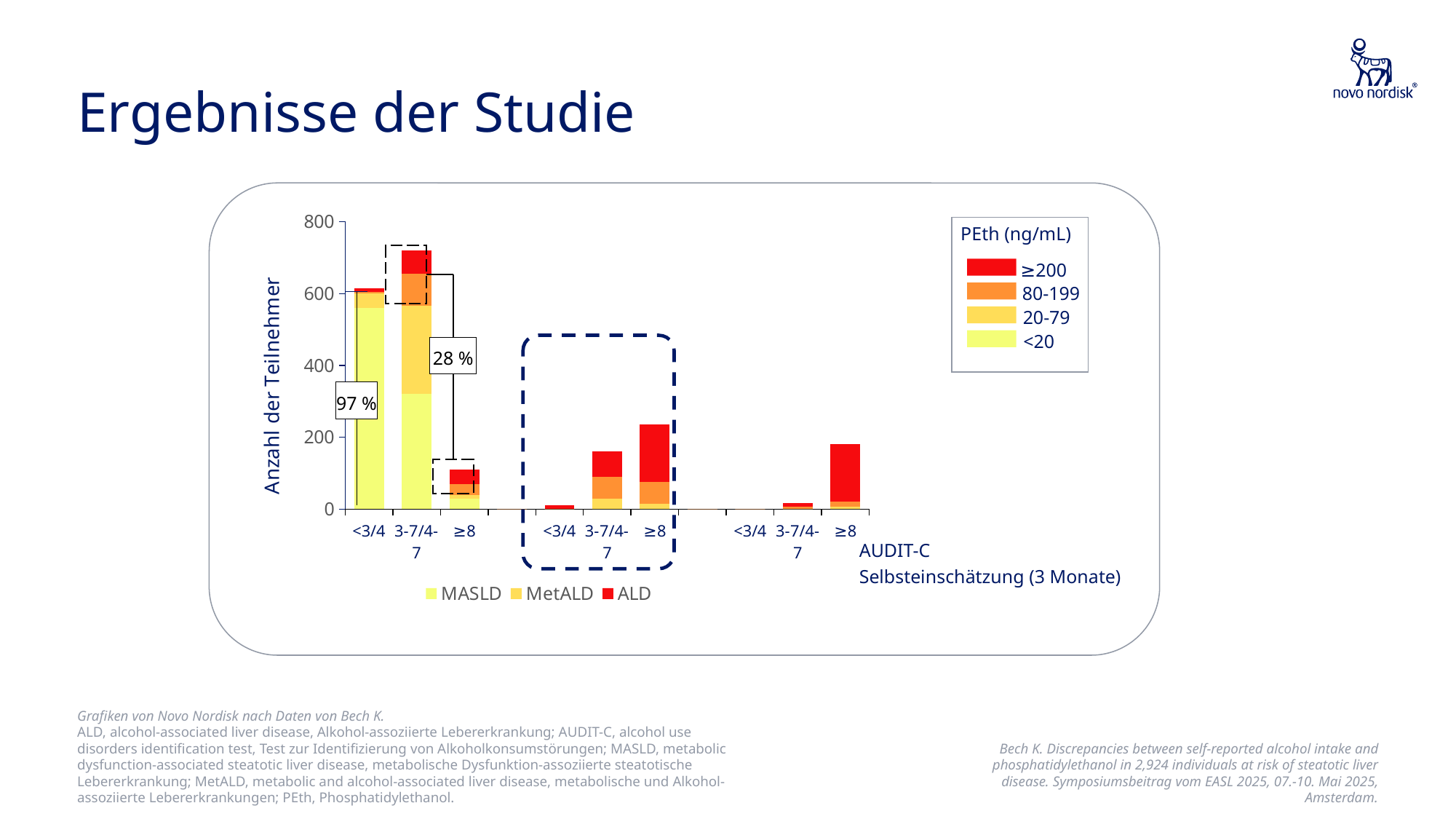
What kind of chart is shown on the slide? stacked bar chart Which bar is the tallest in the chart? MASLD 3-7/4-7 Within the MetALD group, do the bar values rise or fall from <3/4 to ≥8? rise Is the value for the ALD ≥8 bar greater or less than 200? less How many bars are plotted in the chart in total across the MASLD, MetALD and ALD groups? 8 What percentage label is shown on the MASLD <3/4 bar? 97 % Is the value for the MetALD ≥8 bar greater or less than 200? greater Which is larger, the MetALD ≥8 bar or the ALD ≥8 bar? MetALD ≥8 What is the label of the y axis? Anzahl der Teilnehmer How many PEth (ng/mL) categories does the legend list? 4 Is the value for the MASLD 3-7/4-7 bar greater or less than 600? greater